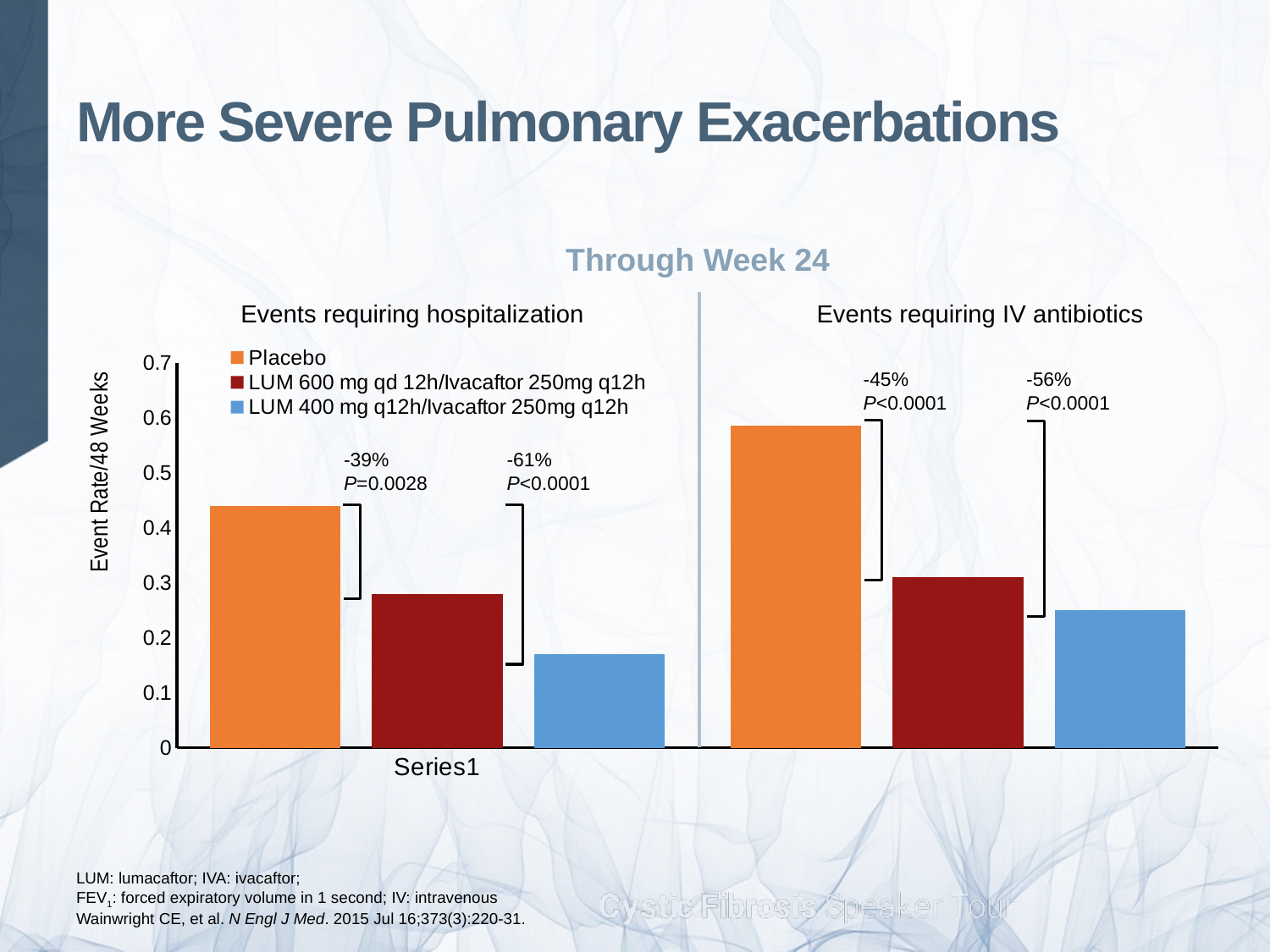
In the 'Events requiring IV antibiotics' chart, is the Placebo event rate greater or less than 0.5? greater In the 'Events requiring IV antibiotics' chart, which is larger: the event rate for LUM 600 mg qd 12h/Ivacaftor 250mg q12h or for LUM 400 mg q12h/Ivacaftor 250mg q12h? LUM 600 mg qd 12h/Ivacaftor 250mg q12h In the 'Events requiring hospitalization' chart, is the Placebo event rate greater or less than 0.4? greater In the 'Events requiring hospitalization' chart, which series has the lowest event rate? LUM 400 mg q12h/Ivacaftor 250mg q12h In the 'Events requiring hospitalization' chart, what percent reduction is annotated for LUM 400 mg q12h/Ivacaftor 250mg q12h versus Placebo? -61% In the 'Events requiring hospitalization' chart, is the LUM 400 mg q12h/Ivacaftor 250mg q12h event rate greater or less than 0.2? less What is the label on the y-axis? Event Rate/48 Weeks In the 'Events requiring IV antibiotics' chart, which series has the highest event rate? Placebo What kind of chart is shown on the slide? Bar chart In the 'Events requiring IV antibiotics' chart, which series has the lowest event rate? LUM 400 mg q12h/Ivacaftor 250mg q12h How many series does the legend list? 3 In the 'Events requiring hospitalization' chart, which series has the highest event rate? Placebo